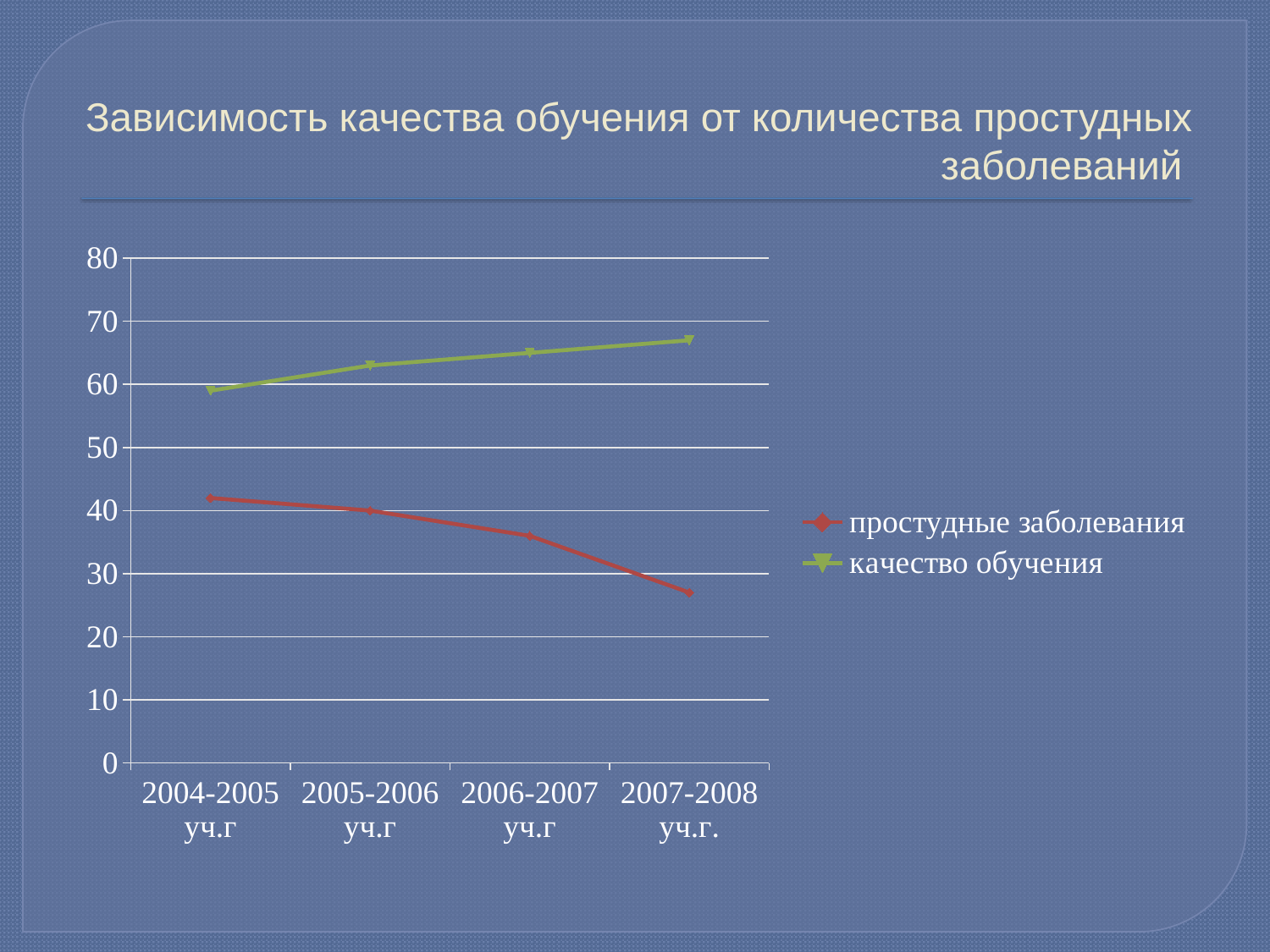
Does the value for качество обучения rise or fall from 2004-2005 уч.г to 2007-2008 уч.г.? rise Is the value for качество обучения in 2004-2005 уч.г greater or less than 50? greater What kind of chart is shown on the slide? line chart In which academic year is простудные заболевания lowest? 2007-2008 уч.г. Is the value for простудные заболевания in 2007-2008 уч.г. greater or less than 30? less In which academic year is качество обучения highest? 2007-2008 уч.г. Is the value for простудные заболевания in 2004-2005 уч.г greater or less than 50? less Which series has the larger value in 2006-2007 уч.г, простудные заболевания or качество обучения? качество обучения How many academic years are shown on the x axis? 4 Does the value for простудные заболевания rise or fall from 2004-2005 уч.г to 2007-2008 уч.г.? fall How many series does the legend list? 2